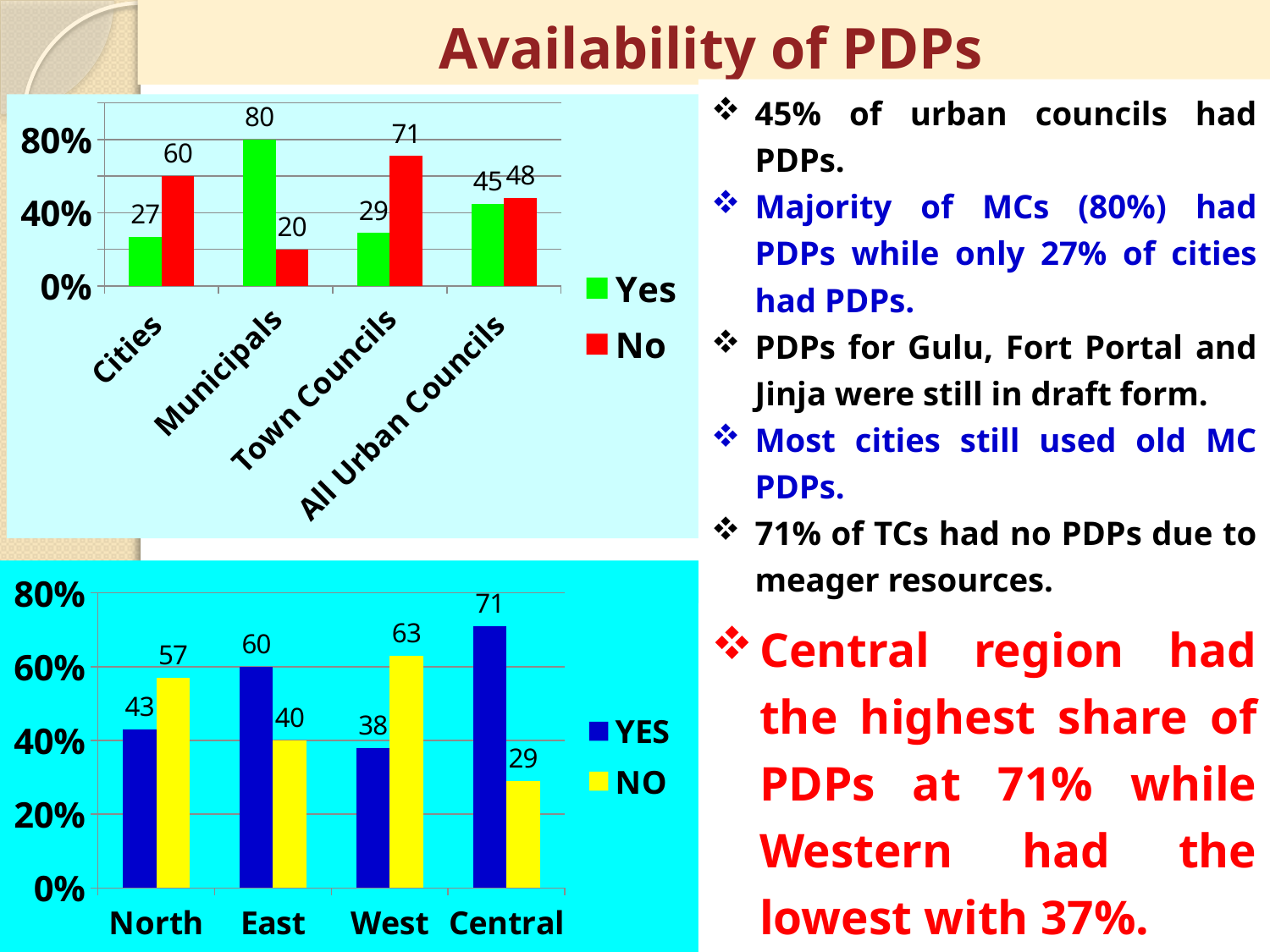
In the bottom chart, which region has the highest YES value? Central In the top chart, how many categories are shown on the x axis? 4 In the bottom chart, what is the NO value for West? 63 In the top chart, what is the difference between the No and Yes values for Cities? 33 In the top chart, which is larger for All Urban Councils, Yes or No? No In the top chart, what is the No value for Town Councils? 71 In the bottom chart, what is the difference between the NO and YES values for North? 14 In the bottom chart, how many series does the legend list? 2 In the top chart, what is the Yes value for Municipals? 80 What kind of chart is the bottom chart? Bar chart In the bottom chart, what is the YES value for Central? 71 In the top chart, which category has the lowest Yes value? Cities